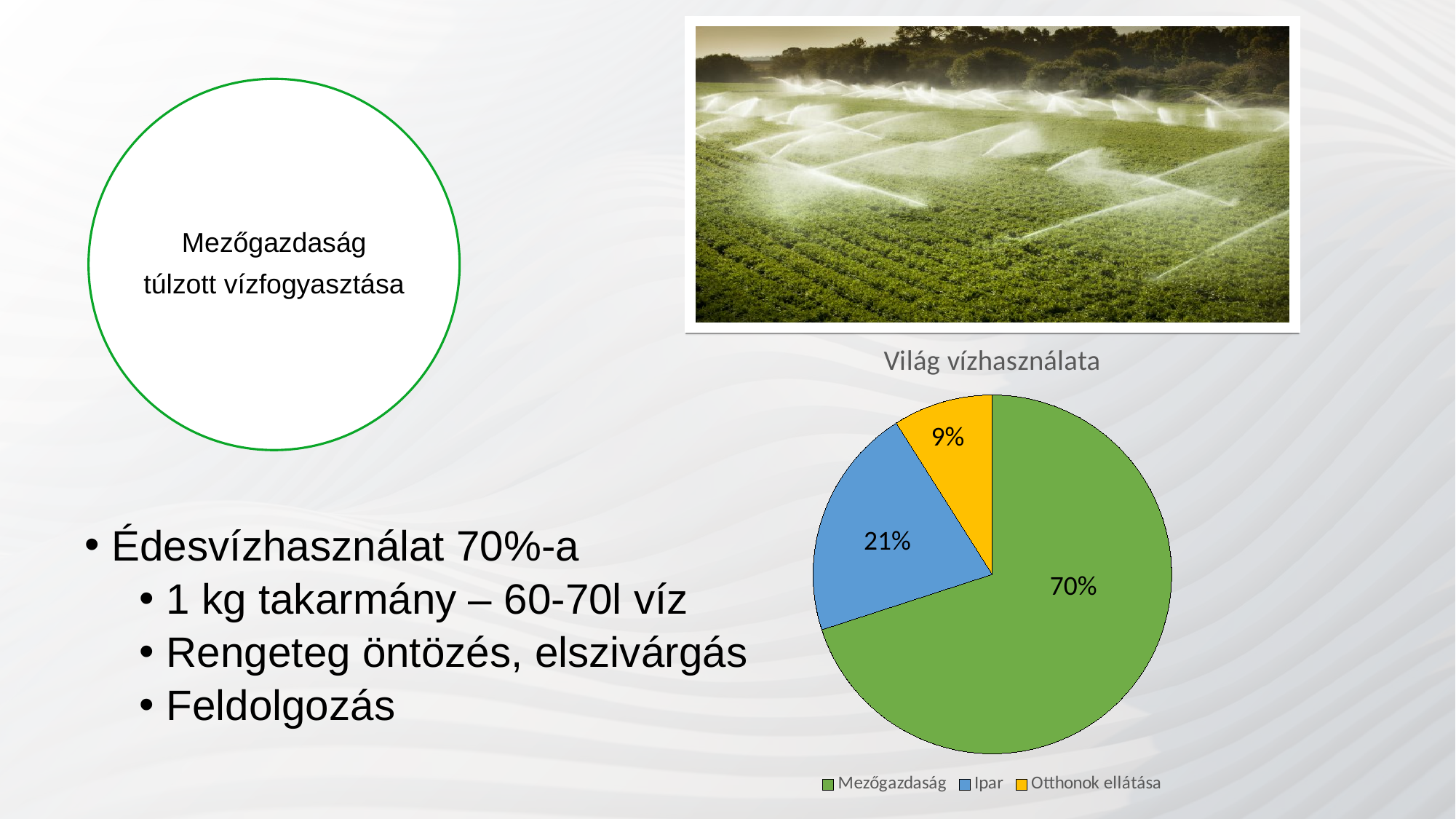
What is the difference in percentage points between Mezőgazdaság and Ipar? 49 What share of the pie does Ipar have? 21% What share of the pie does Mezőgazdaság have? 70% What share of the pie does Otthonok ellátása have? 9% How many categories does the pie chart show? 3 What is the difference in percentage points between Ipar and Otthonok ellátása? 12 What colour is the slice for Ipar? blue What type of chart is shown on the slide? pie chart Which category has the smallest slice of the pie? Otthonok ellátása What is the title of the pie chart? Világ vízhasználata Which is larger, the share for Ipar or the share for Otthonok ellátása? Ipar Which category has the largest slice of the pie? Mezőgazdaság